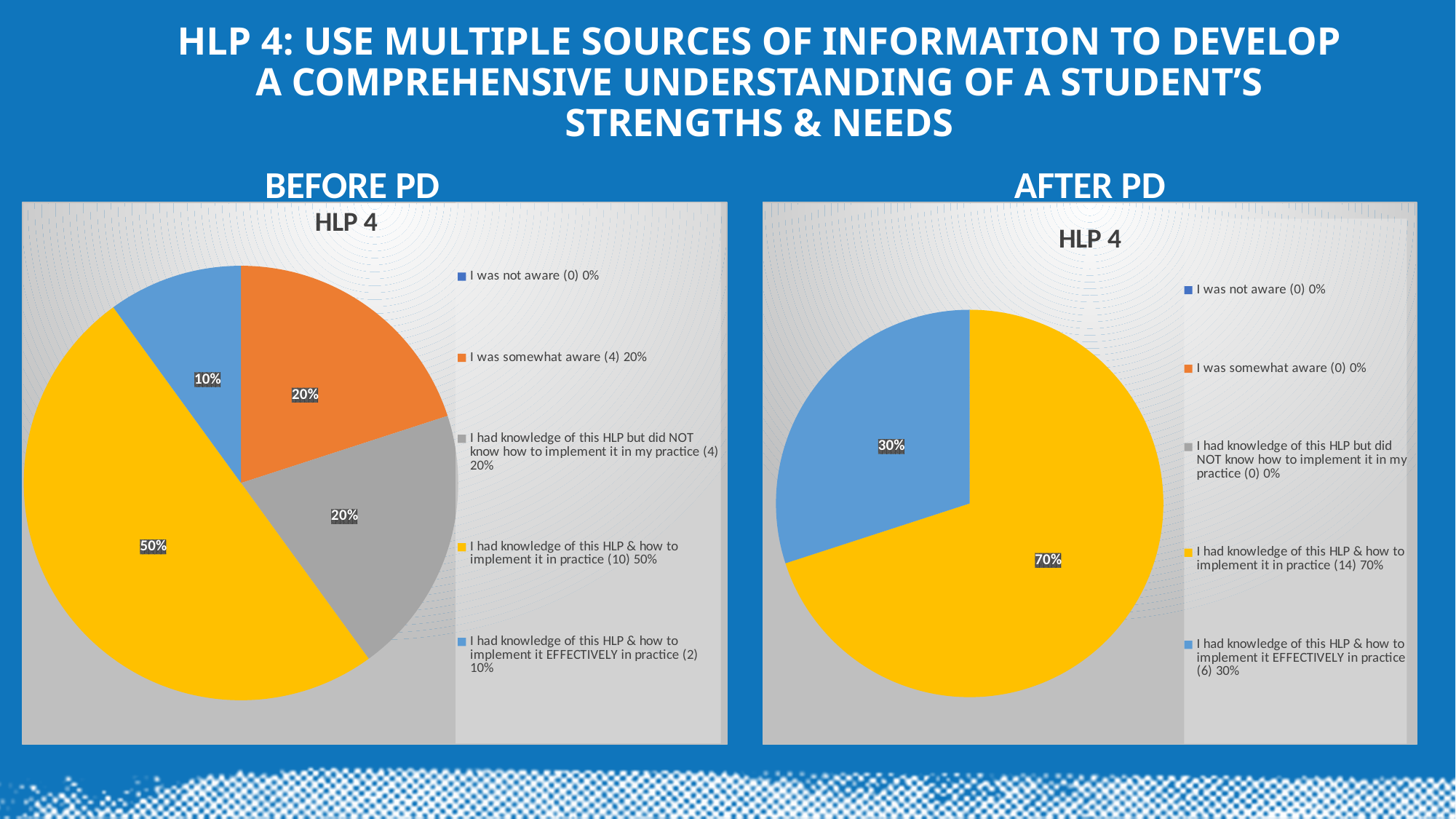
In the AFTER PD chart, what percentage is shown for 'I was somewhat aware'? 0% In the AFTER PD chart, how many respondents selected 'I had knowledge of this HLP & how to implement it EFFECTIVELY in practice'? 6 What is the title shown inside both pie charts? HLP 4 In the BEFORE PD chart, what share of the pie is 'I had knowledge of this HLP & how to implement it in practice'? 50% In the AFTER PD chart, what share of the pie is 'I had knowledge of this HLP & how to implement it in practice'? 70% In the AFTER PD chart, what is the difference in percentage points between the 'implement it in practice' slice and the 'implement it EFFECTIVELY in practice' slice? 40% In the BEFORE PD chart, what percentage is shown for 'I was somewhat aware'? 20% In the BEFORE PD chart, which is larger: the 'I was somewhat aware' slice or the 'implement it EFFECTIVELY in practice' slice? I was somewhat aware In the BEFORE PD chart, how many respondents selected 'I had knowledge of this HLP & how to implement it EFFECTIVELY in practice'? 2 In the BEFORE PD chart, which category has the largest share? I had knowledge of this HLP & how to implement it in practice How many entries does the legend of the AFTER PD chart list? 5 What type of chart is used in the BEFORE PD chart? pie chart